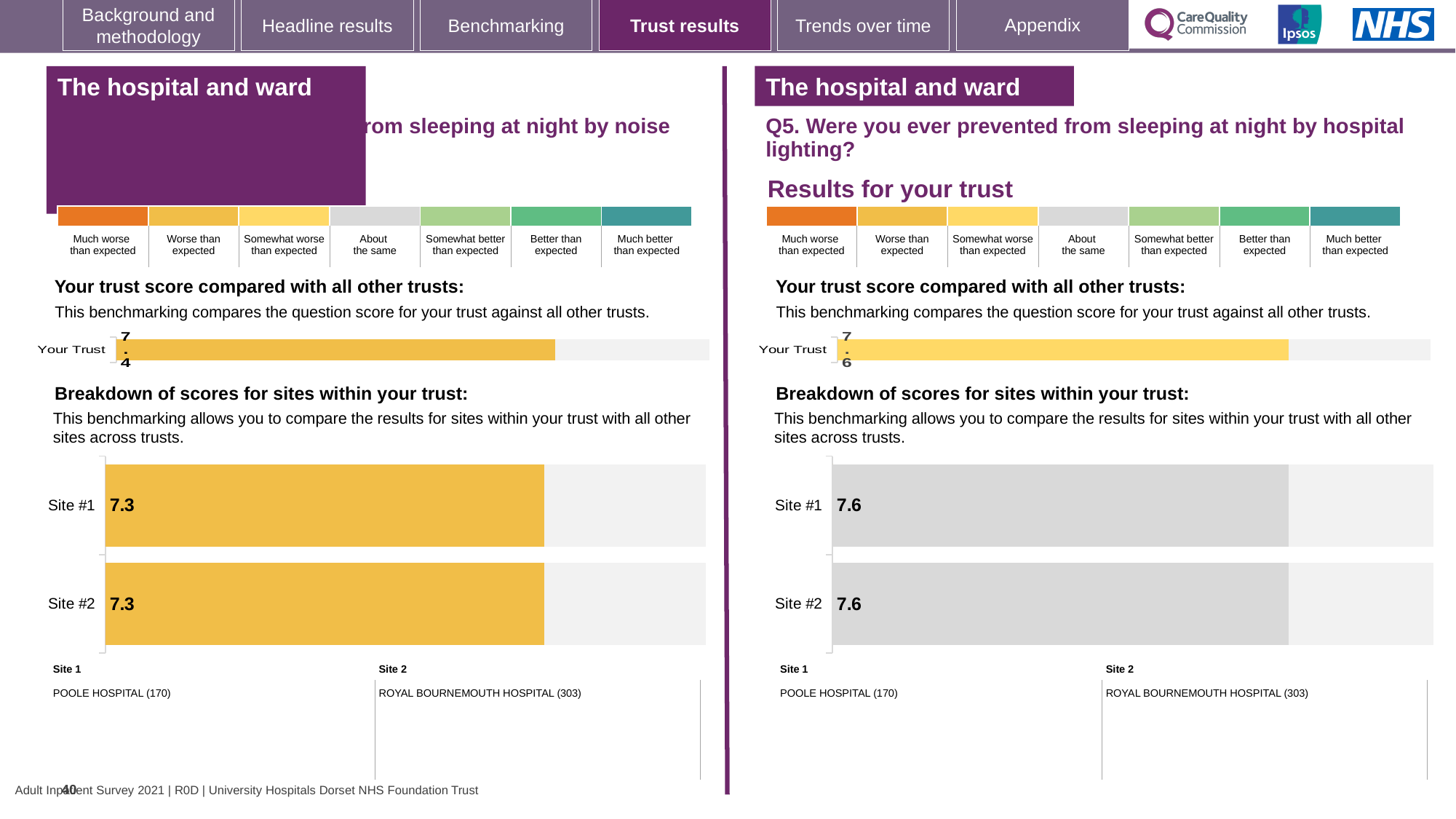
What colour are the bars in the right-hand site breakdown chart for Q5? Grey According to the key below the right-hand site breakdown chart, which hospital is Site 1? POOLE HOSPITAL (170) In the right-hand 'Your trust score compared with all other trusts' chart for Q5, what is the value shown for Your Trust? 7.6 In the right-hand chart for Q5 (hospital lighting), what is the score shown for Site #1? 7.6 In the left-hand 'Your trust score compared with all other trusts' chart, what is the value shown for Your Trust? 7.4 In the left-hand site breakdown chart, do Site #1 and Site #2 have the same score? Yes, both 7.3 What kind of chart is used for the site breakdown on the right-hand side of the slide? Bar chart What is the difference between the Site #2 score in the right-hand chart and the Site #2 score in the left-hand chart? 0.3 In the left-hand site breakdown chart (sleeping at night by noise), what is the score shown for Site #2? 7.3 Which is larger: the Site #1 score in the left-hand (noise) chart or the Site #1 score in the right-hand (lighting) chart? The right-hand (lighting) chart, 7.6 How many sites are shown in the left-hand 'Breakdown of scores for sites within your trust' chart? 2 What is the difference between the Your Trust score in the right-hand chart (7.6) and the Your Trust score in the left-hand chart (7.4)? 0.2